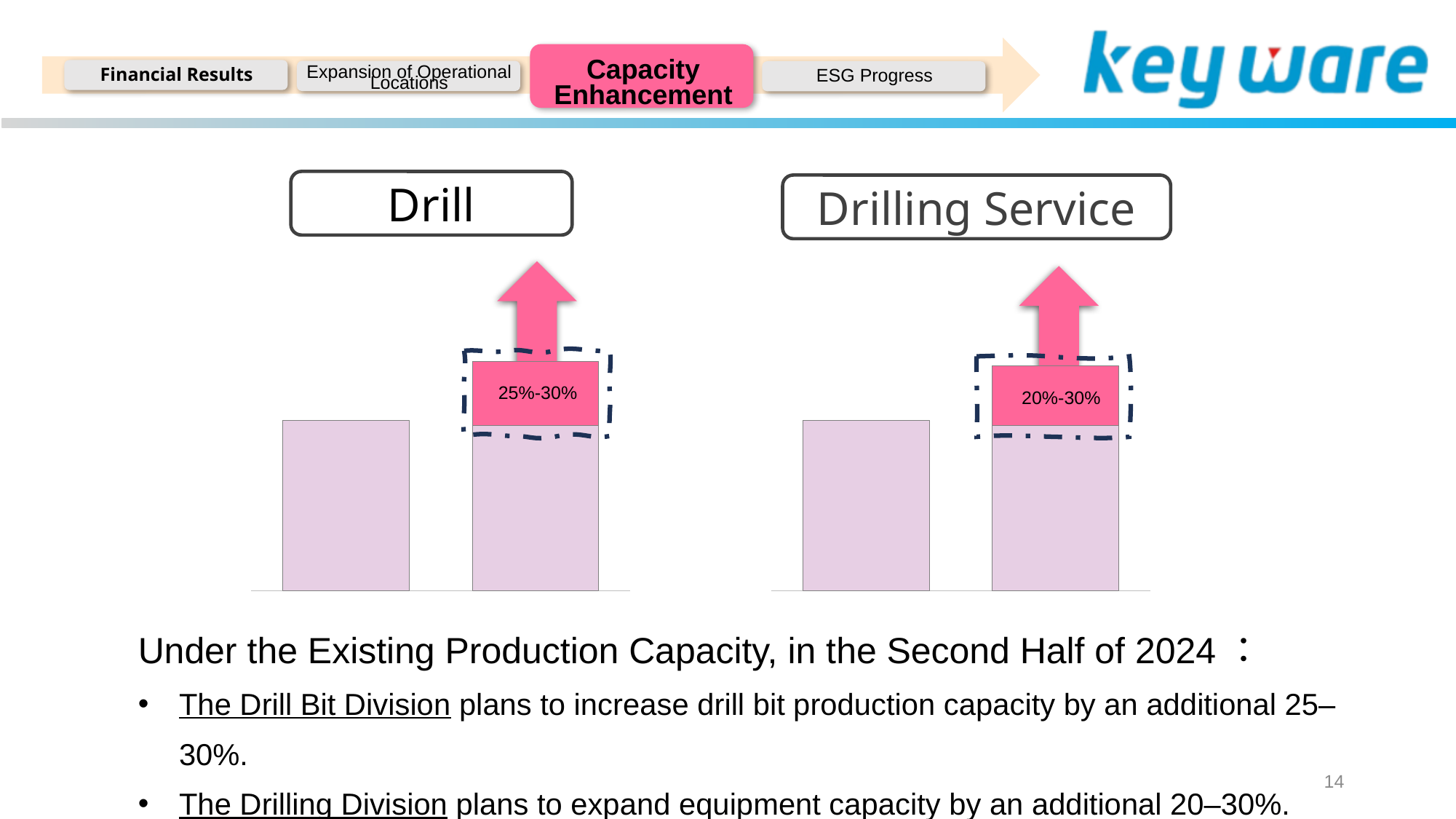
In the "Drilling Service" chart, what colour is the segment showing the additional capacity? pink In the "Drill" chart, what percentage increase is printed on the pink segment of the right bar? 25%-30% How many bars are plotted in the "Drilling Service" chart? 2 In the "Drill" chart, which bar is taller, the left bar or the right bar? the right bar What are the titles of the two charts on the slide? Drill and Drilling Service How many bars are plotted in the "Drill" chart? 2 In the "Drilling Service" chart, do the bars rise or fall from left to right? rise What kind of chart is shown under the "Drill" heading? bar chart In the "Drilling Service" chart, what percentage increase is printed on the pink segment of the right bar? 20%-30%